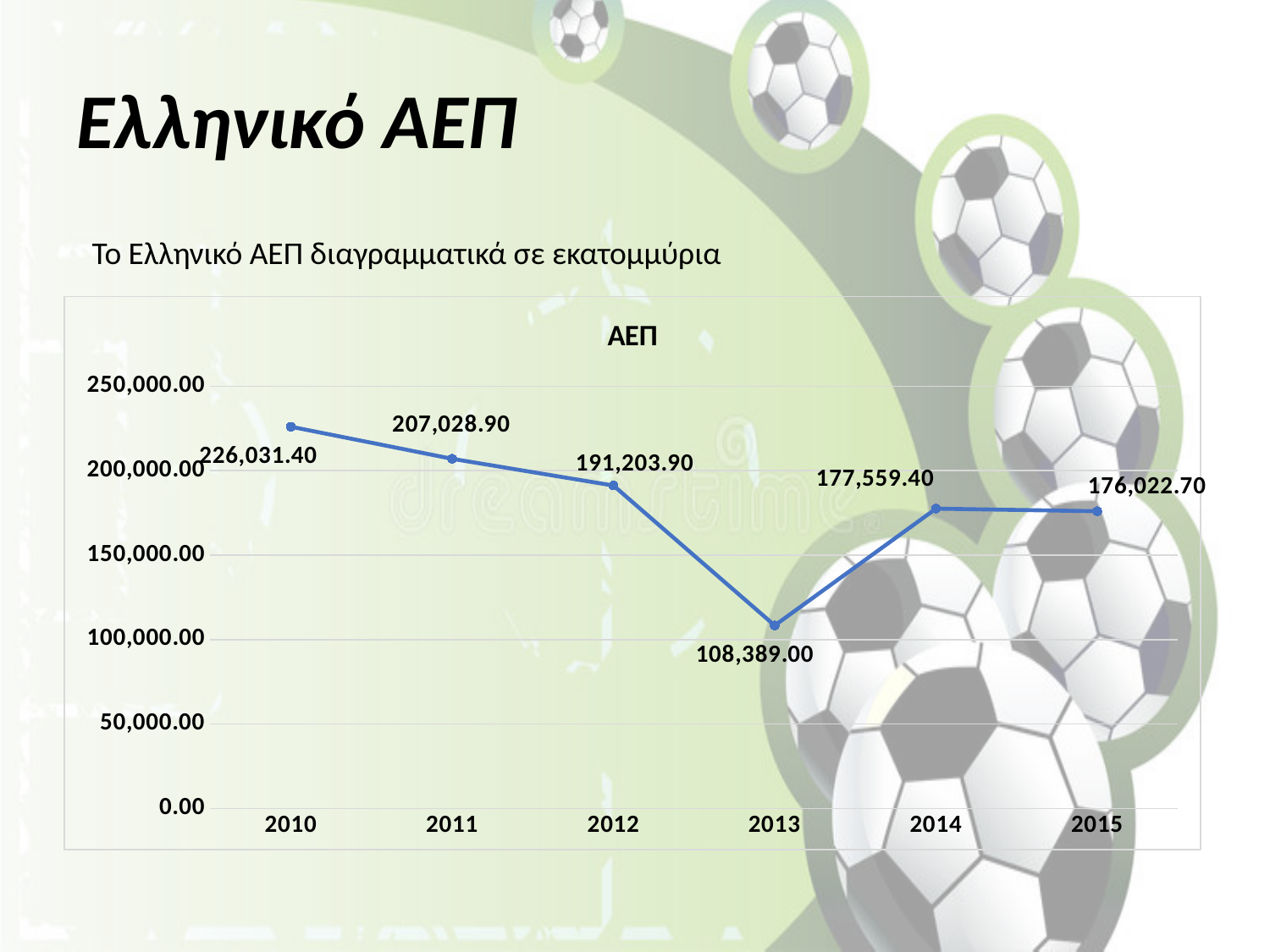
What kind of chart is the ΑΕΠ chart? line chart What is the value for 2015 in the ΑΕΠ chart? 176,022.70 Is the value for 2012 in the ΑΕΠ chart greater or less than 200,000.00? less How many years are plotted in the ΑΕΠ chart? 6 By how much did the value increase from 2013 to 2014 in the ΑΕΠ chart? 69,170.40 Which year has the lowest value in the ΑΕΠ chart? 2013 Which year has the highest value in the ΑΕΠ chart? 2010 Which year has the larger value in the ΑΕΠ chart, 2014 or 2015? 2014 What is the difference between the values for 2010 and 2011 in the ΑΕΠ chart? 19,002.50 What is the value for 2013 in the ΑΕΠ chart? 108,389.00 What is the value for 2010 in the ΑΕΠ chart? 226,031.40 Do the values in the ΑΕΠ chart rise or fall from 2010 to 2013? fall